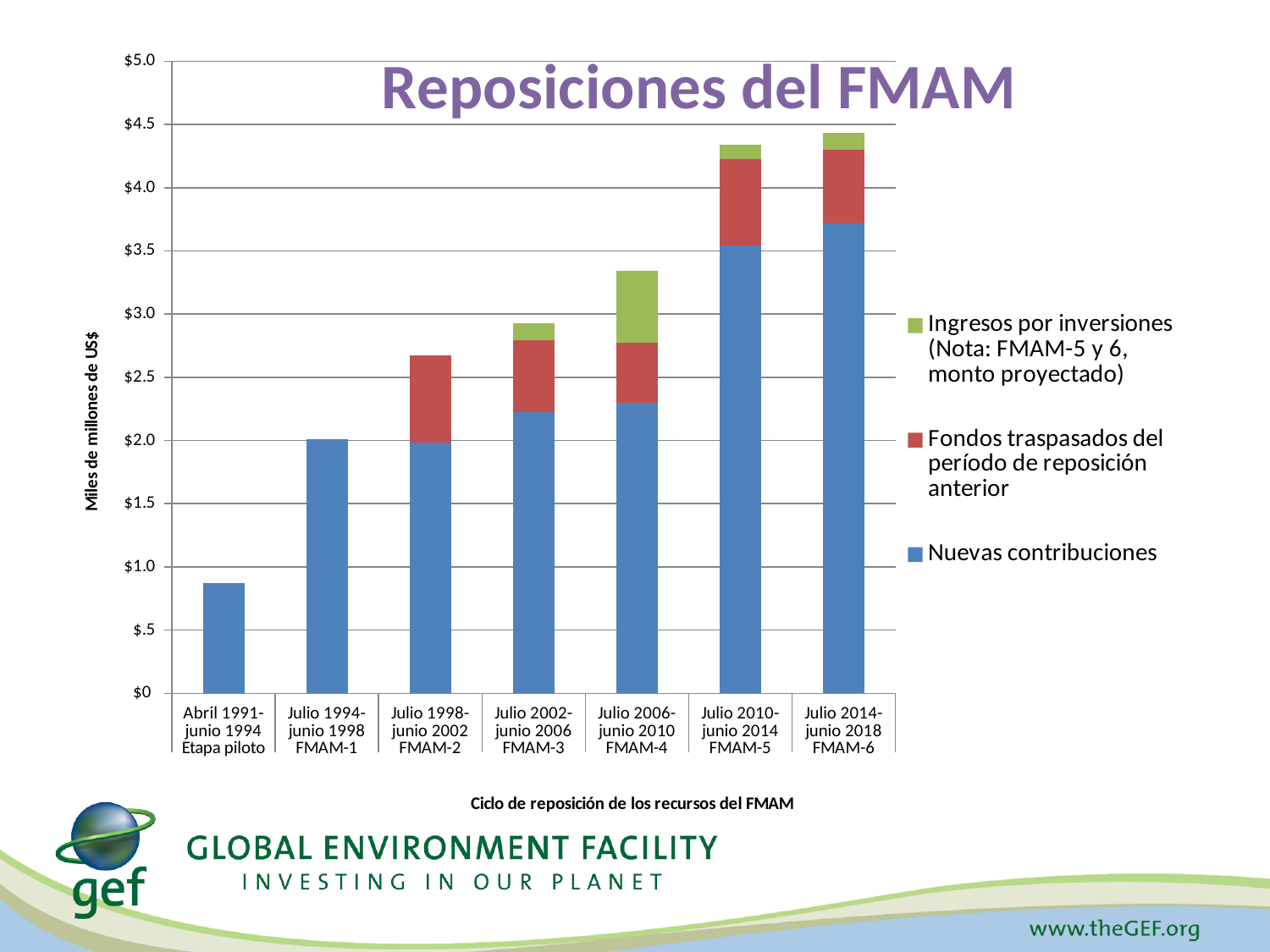
Which has the larger total bar, FMAM-3 or FMAM-4? FMAM-4 Is the total value for FMAM-2 greater or less than $2.5? greater Is the total value for the Etapa piloto bar greater or less than $1.0? less What is the title of the chart? Reposiciones del FMAM Which replenishment period has the highest total bar? Julio 2014-junio 2018 FMAM-6 How many series does the legend list? 3 Is the total value for FMAM-5 greater or less than $4.0? greater How many replenishment periods (categories) are shown on the x axis? 7 What kind of chart is shown on the slide? Stacked bar chart Do the total bar heights generally rise or fall from the Etapa piloto to FMAM-6? rise Which replenishment period has the lowest total bar? Abril 1991-junio 1994 Etapa piloto